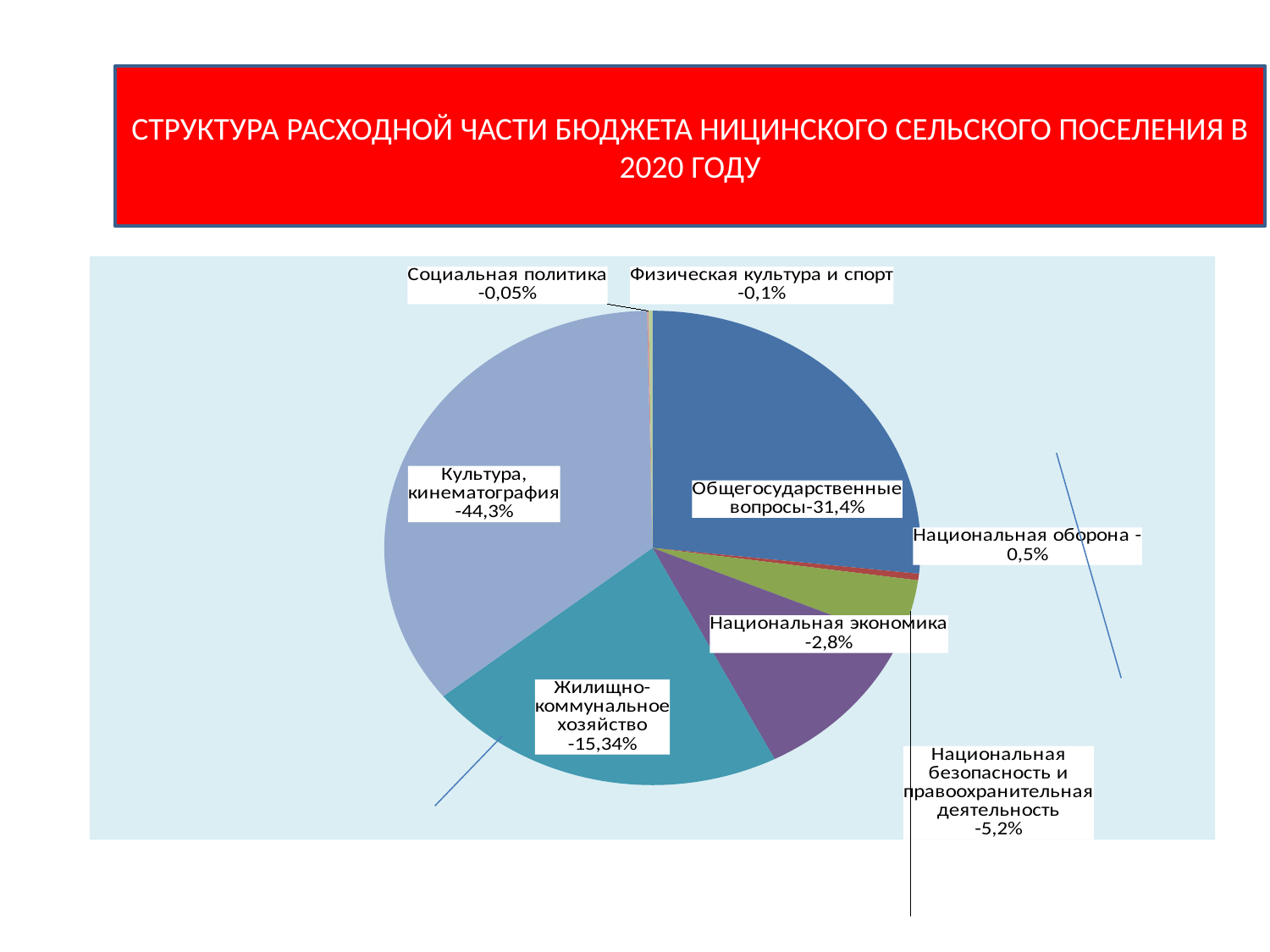
What share is shown for Национальная оборона? 0,5% What share is shown for Общегосударственные вопросы? 31,4% Which category has the largest share of the pie? Культура, кинематография What kind of chart is shown on the slide? Pie chart What share is shown for Национальная безопасность и правоохранительная деятельность? 5,2% What year does the chart title say the budget expenditure structure refers to? 2020 Which is larger: the share for Национальная экономика or the share for Национальная безопасность и правоохранительная деятельность? Национальная безопасность и правоохранительная деятельность Which category has the smallest share of the pie? Социальная политика What share of the budget expenditure goes to Культура, кинематография? 44,3% What is the difference between the shares for Культура, кинематография and Общегосударственные вопросы? 12,9% What share is shown for Жилищно-коммунальное хозяйство? 15,34% How many categories are shown in the pie chart? 8